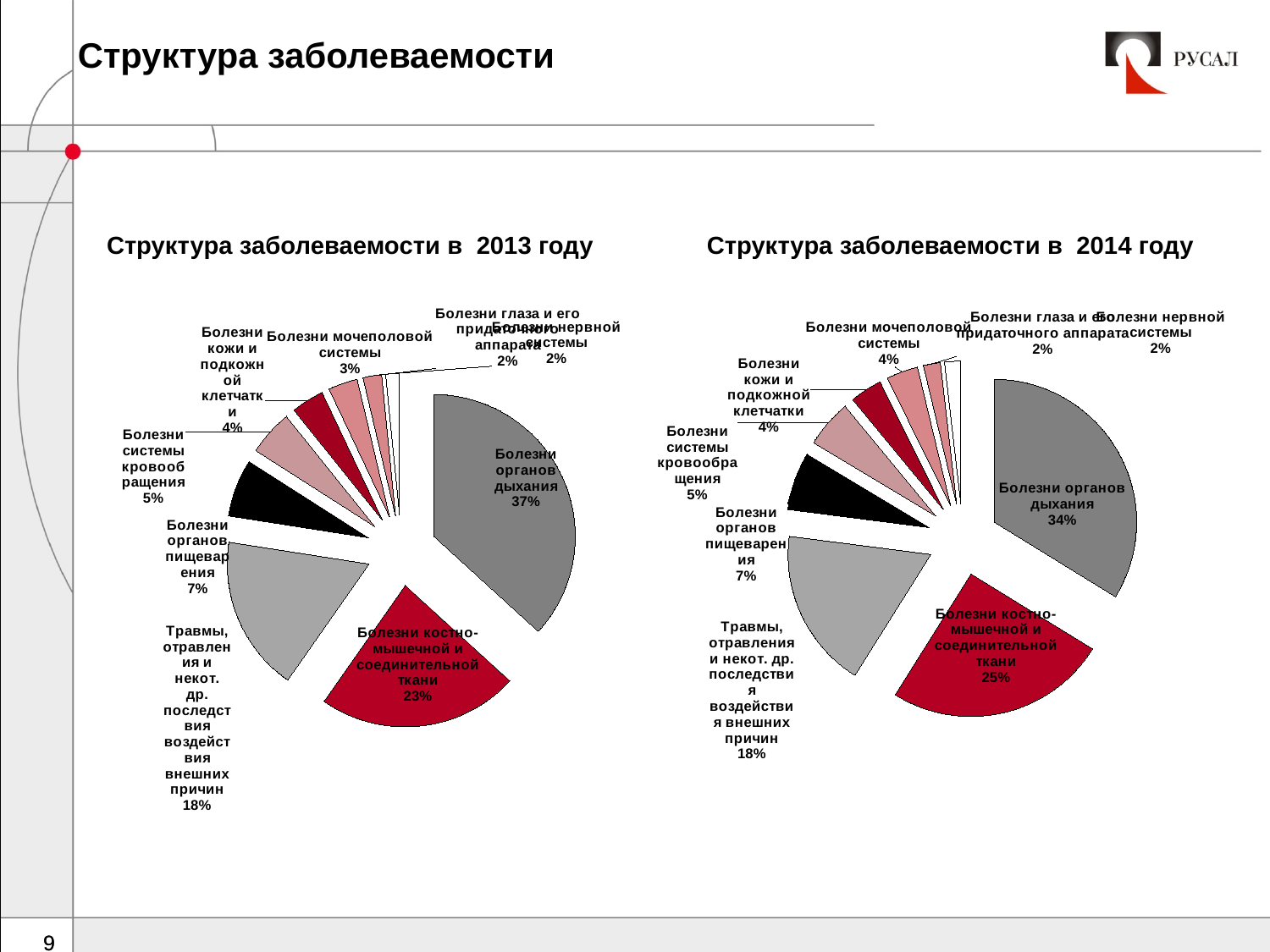
What is the title of the chart on the right side of the slide? Структура заболеваемости в 2014 году In the 2013 chart, what share is Болезни системы кровообращения? 5% What is the difference between the share of Болезни органов дыхания in the 2013 chart and in the 2014 chart? 3% In the 2013 chart, what share is Болезни костно-мышечной и соединительной ткани? 23% In the 2014 chart, which category has the largest share? Болезни органов дыхания In the 2014 chart, what share is Болезни мочеполовой системы? 4% In the 2014 chart, what share is Болезни костно-мышечной и соединительной ткани? 25% In the 2013 chart, which is larger: Травмы, отравления и некот. др. последствия воздействия внешних причин or Болезни органов пищеварения? Травмы, отравления и некот. др. последствия воздействия внешних причин What type of chart is used on this slide for the 2013 and 2014 data? Pie chart In the 2013 chart, which category has the largest share? Болезни органов дыхания In the 2013 chart (Структура заболеваемости в 2013 году), what share is Болезни органов дыхания? 37% In the 2014 chart (Структура заболеваемости в 2014 году), what share is Болезни органов дыхания? 34%